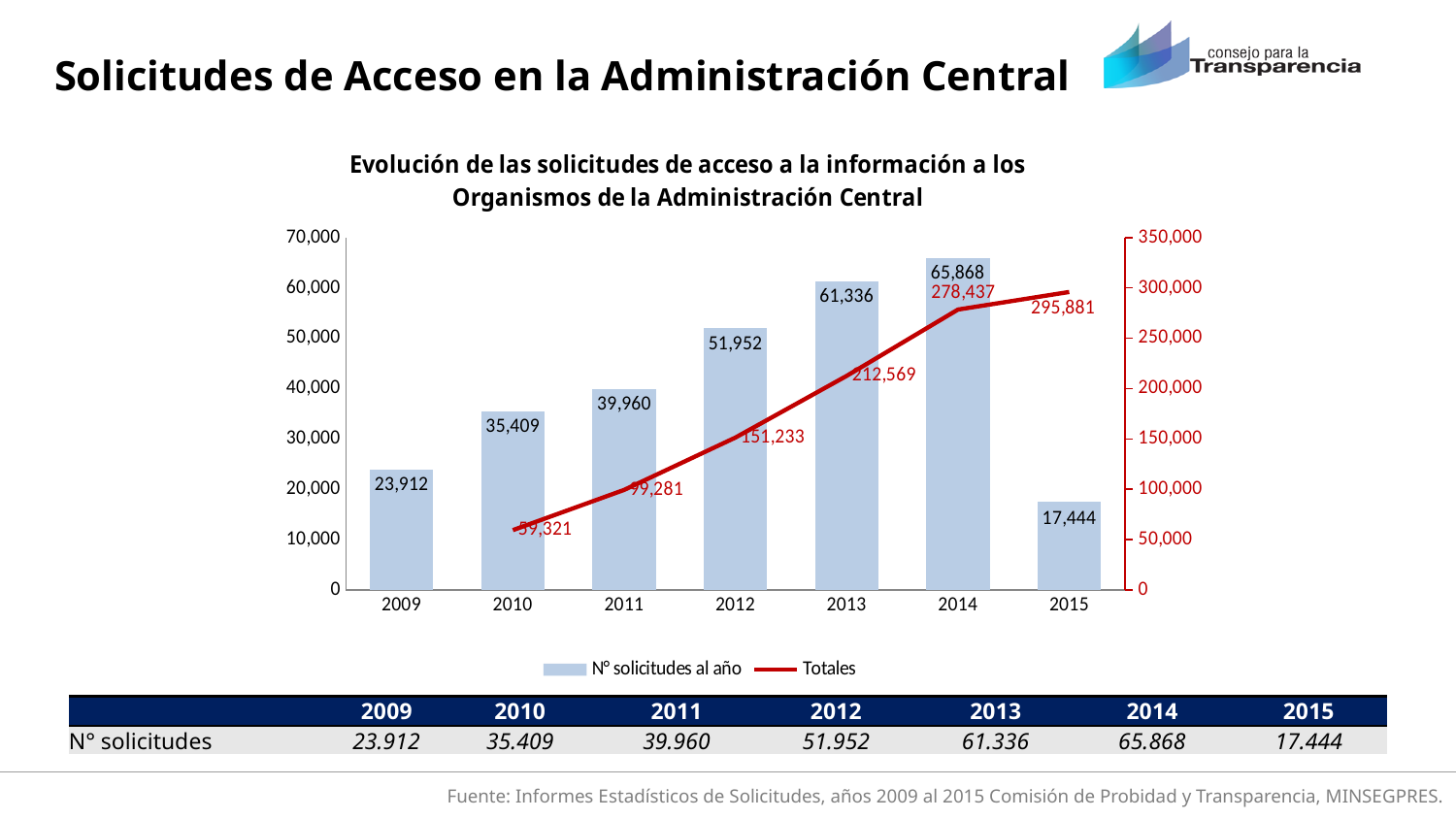
Which year has the highest value for N° solicitudes al año? 2014 What is the value of Totales for 2012? 151,233 What kind of chart is shown on the slide? Combined bar and line chart How many series does the chart legend list? 2 What colour is the Totales line in the chart? Red Which year has the lowest value for N° solicitudes al año? 2015 What is the value of N° solicitudes al año for 2012? 51,952 Which is larger, the N° solicitudes al año value for 2010 or for 2011? 2011 What is the difference between the N° solicitudes al año values for 2014 and 2013? 4,532 Does the Totales line rise or fall from 2010 to 2015? Rises What is the value of Totales for 2014? 278,437 How many years are shown on the x axis of the chart? 7